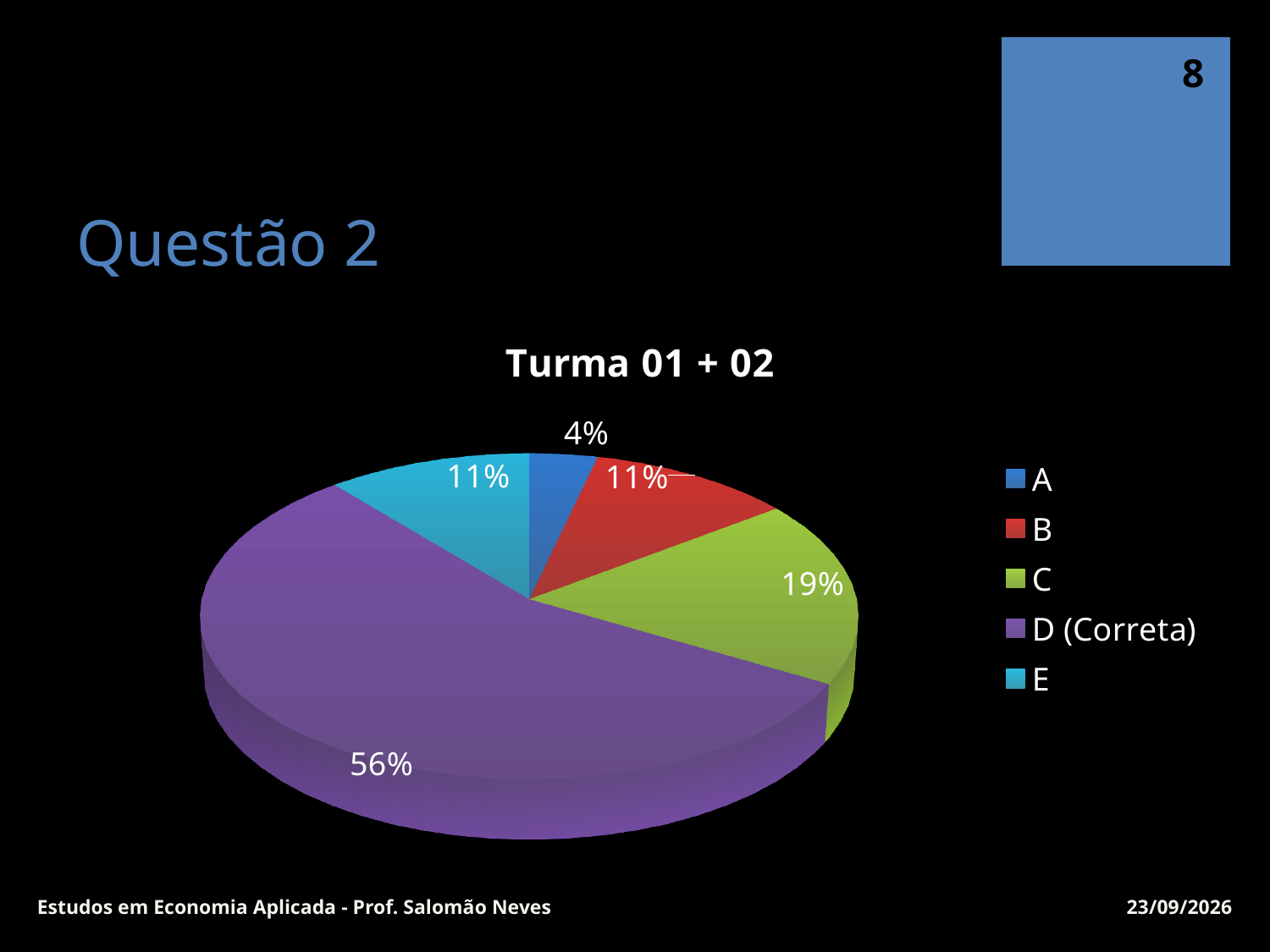
What share of the pie does A have? 4% Which category has the smallest slice of the pie? A Which category has the largest slice of the pie? D (Correta) Which legend entry is marked as the correct answer? D (Correta) Which is larger, the share of C or the share of E? C What share of the pie does C have? 19% What kind of chart is shown on the slide? pie chart What share of the pie does B have? 11% What is the difference between the shares of D (Correta) and C? 37% What is the title of the chart? Turma 01 + 02 How many categories does the legend list? 5